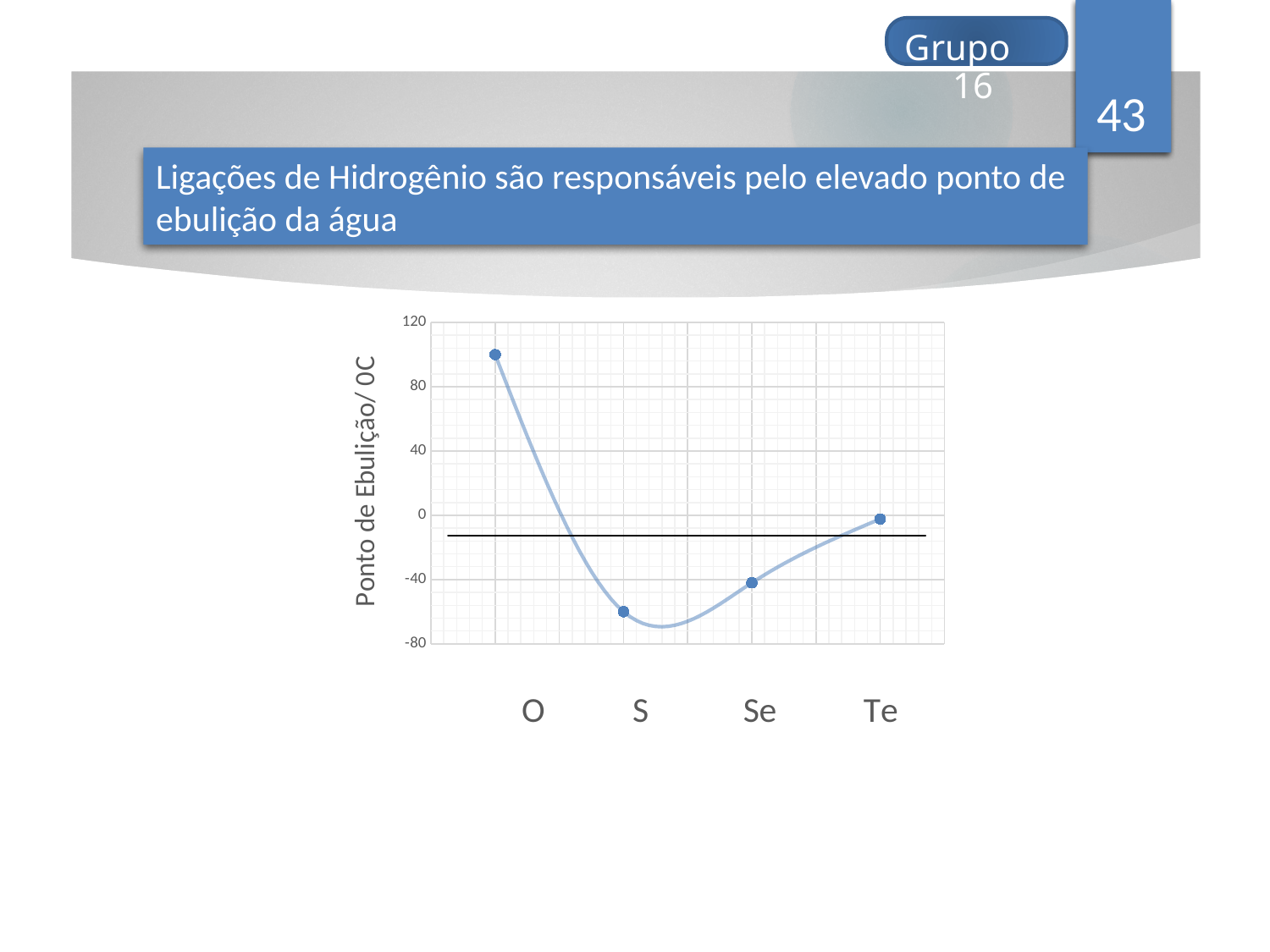
Is the value for O greater or less than 80? greater Is the value for S greater or less than -40? less Which has a higher boiling point, O or S? O Is the value for Te greater or less than -40? greater Do the values rise or fall from S to Te along the x axis? rise Which element has the highest boiling point on the chart? O Which has a higher boiling point, Se or S? Se How many data points are plotted on the chart? 4 Which element has the lowest boiling point on the chart? S What is the title of the vertical axis? Ponto de Ebulição/ 0C What kind of chart is shown on the slide? line chart